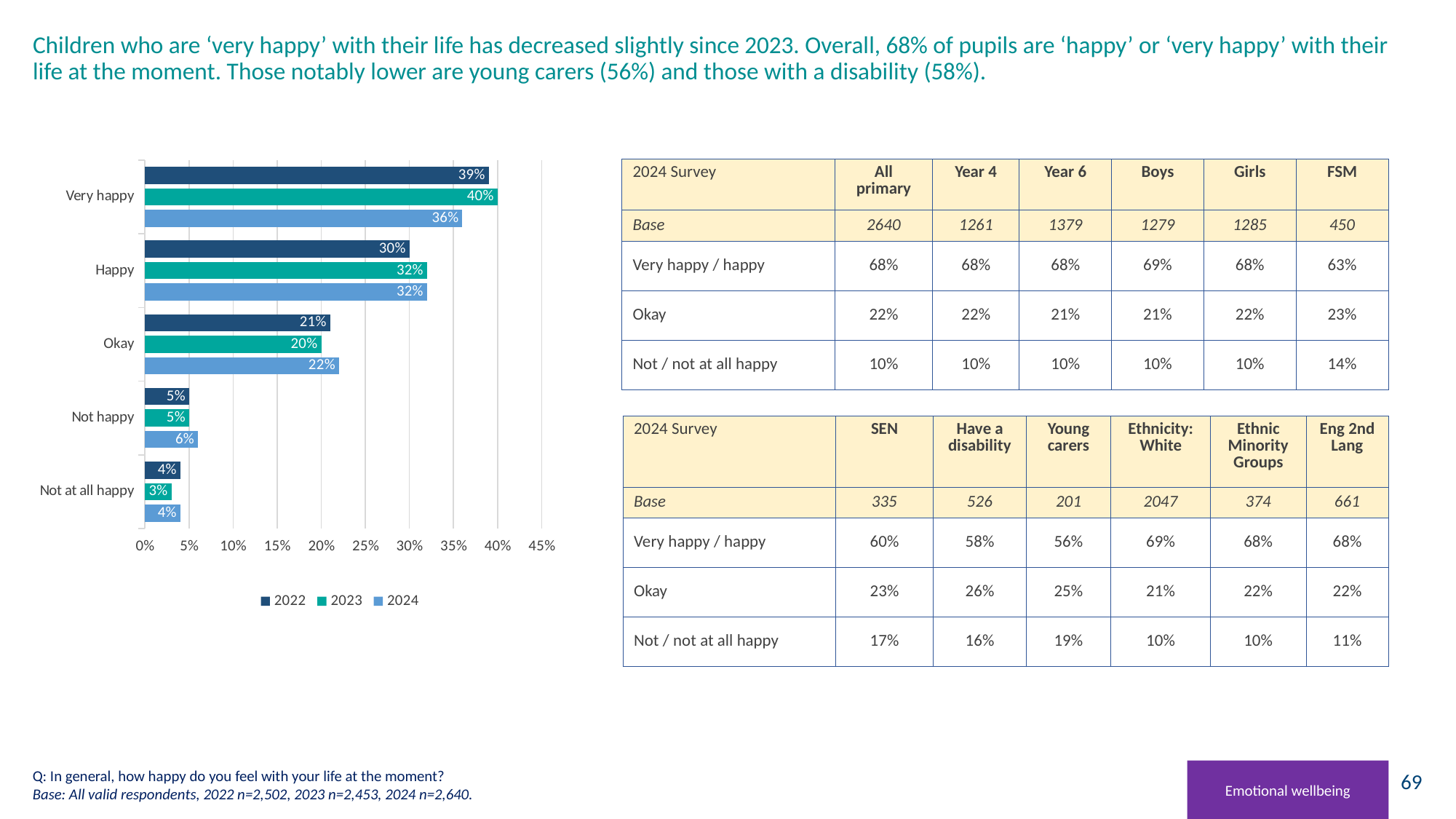
What are the series names listed in the chart legend? 2022, 2023, 2024 Which is larger for 'Okay': the 2023 value or the 2024 value? 2024 How many series does the legend list? 3 What is the difference between the 2023 and 2024 values for 'Very happy'? 4% What kind of chart is shown on the slide? Bar chart Which category has the lowest value for the 2023 series? Not at all happy Which category has the highest value for the 2023 series? Very happy How many categories are shown on the chart? 5 What is the 2024 value for 'Not happy'? 6% What is the 2023 value for 'Happy'? 32% What is the 2024 value for 'Very happy'? 36% What is the 2022 value for 'Okay'? 21%